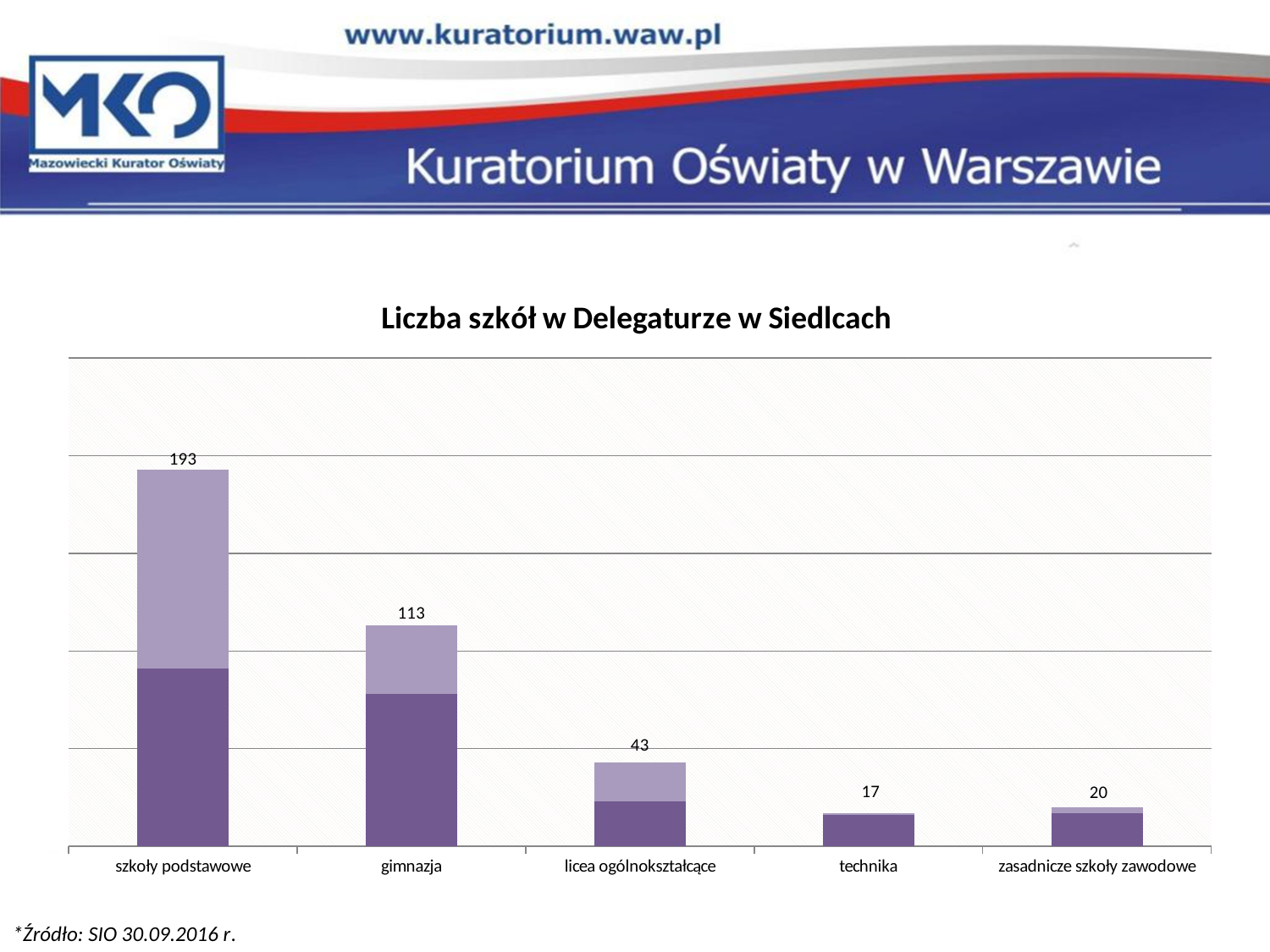
What value is labelled on the bar for licea ogólnokształcące? 43 Which category has the lowest value? technika What value is labelled on the bar for zasadnicze szkoły zawodowe? 20 Which category has the highest value? szkoły podstawowe How many categories are shown on the x axis? 5 What is the difference between the values for szkoły podstawowe and gimnazja? 80 Which is larger, the value for gimnazja or the value for licea ogólnokształcące? gimnazja What value is labelled on the bar for gimnazja? 113 What value is labelled on the bar for technika? 17 What is the total number of schools shown for szkoły podstawowe? 193 What is the difference between the values for zasadnicze szkoły zawodowe and technika? 3 What is the title of the chart? Liczba szkół w Delegaturze w Siedlcach